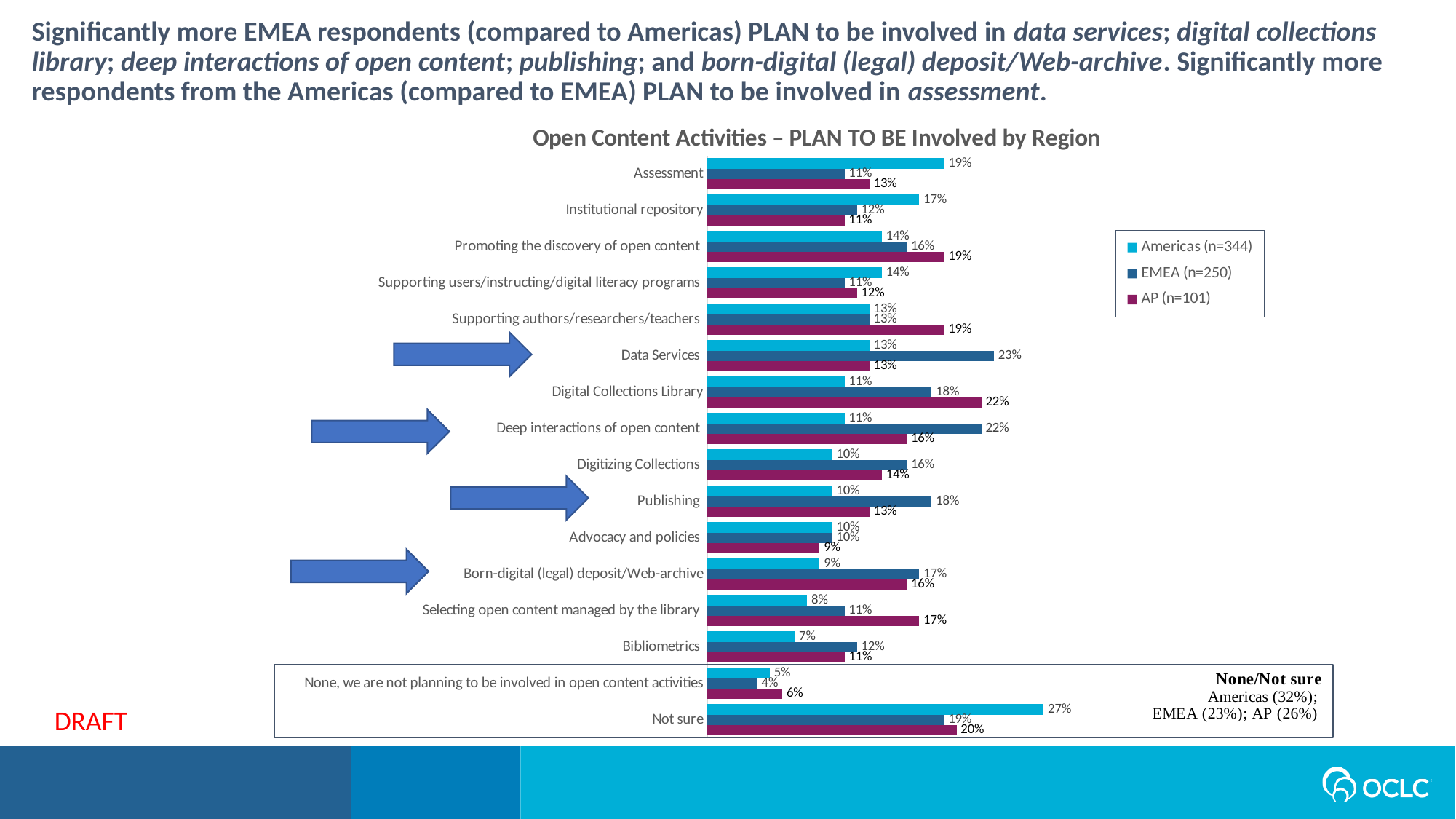
What kind of chart is shown on the slide? Bar chart What is the value for EMEA (n=250) for Data Services? 23% Which category has the highest value for Americas (n=344)? Not sure What is the difference between the Americas (n=344) and EMEA (n=250) values for Publishing? 8% What is the value for Americas (n=344) for Not sure? 27% Which is larger for Assessment: the Americas (n=344) value or the EMEA (n=250) value? Americas (n=344) How many series does the legend list? 3 Which category has the lowest value for EMEA (n=250)? None, we are not planning to be involved in open content activities What is the difference between the EMEA (n=250) and Americas (n=344) values for Deep interactions of open content? 11% What is the value for AP (n=101) for Digital Collections Library? 22% How many categories are shown on the chart? 16 What is the title of the chart? Open Content Activities – PLAN TO BE Involved by Region